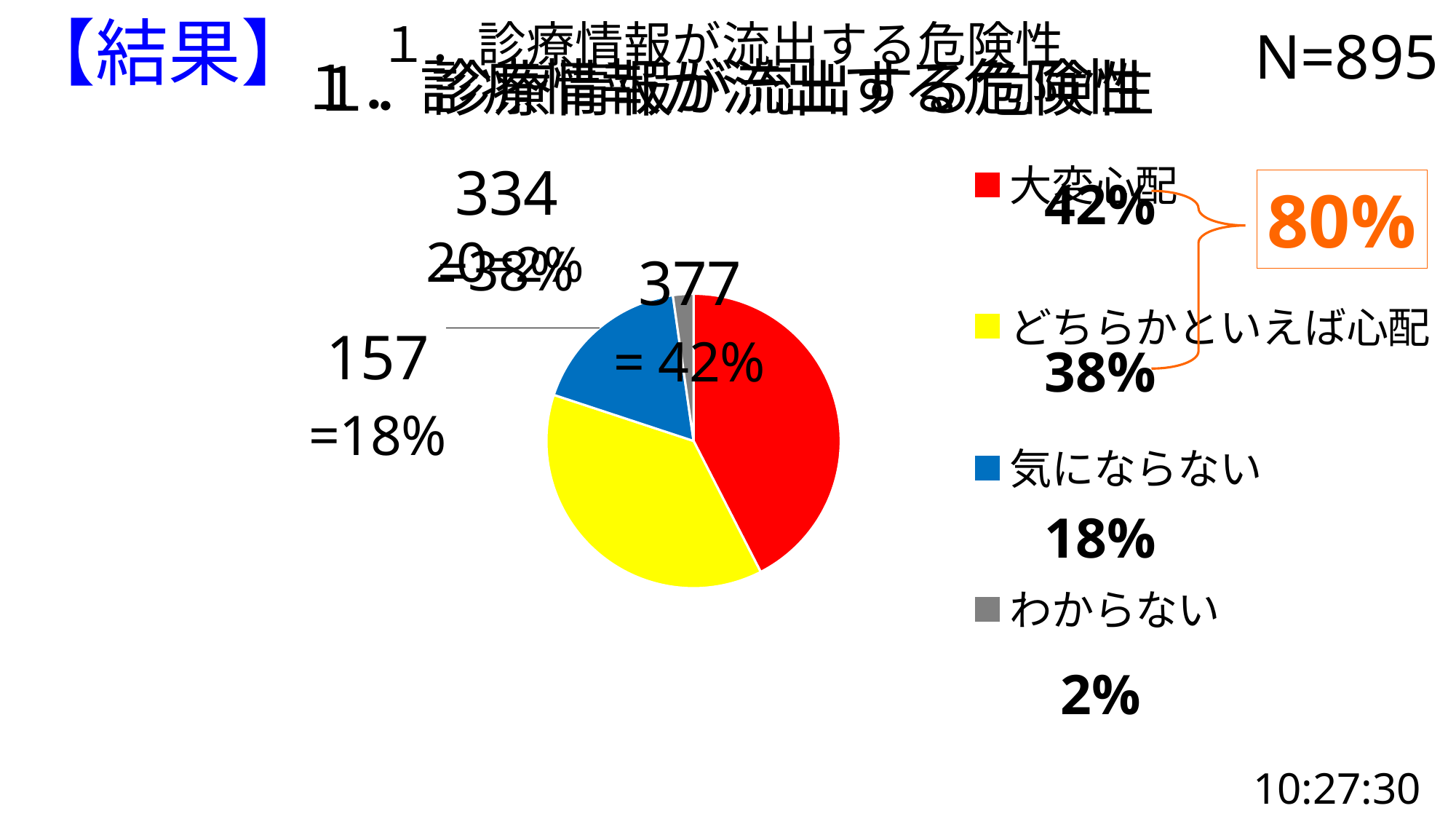
How many respondents answered 気にならない? 157 What colour is the slice for どちらかといえば心配? yellow How many respondents answered 大変心配? 377 Which category has the largest slice of the pie? 大変心配 What percentage of the pie does わからない represent? 2% Which category has the smallest slice of the pie? わからない What percentage of the pie does 大変心配 represent? 42% What percentage of the pie does 気にならない represent? 18% What kind of chart is shown on the slide? pie chart How many categories does the pie chart's legend list? 4 What is the difference in respondents between 大変心配 (377) and 気にならない (157)? 220